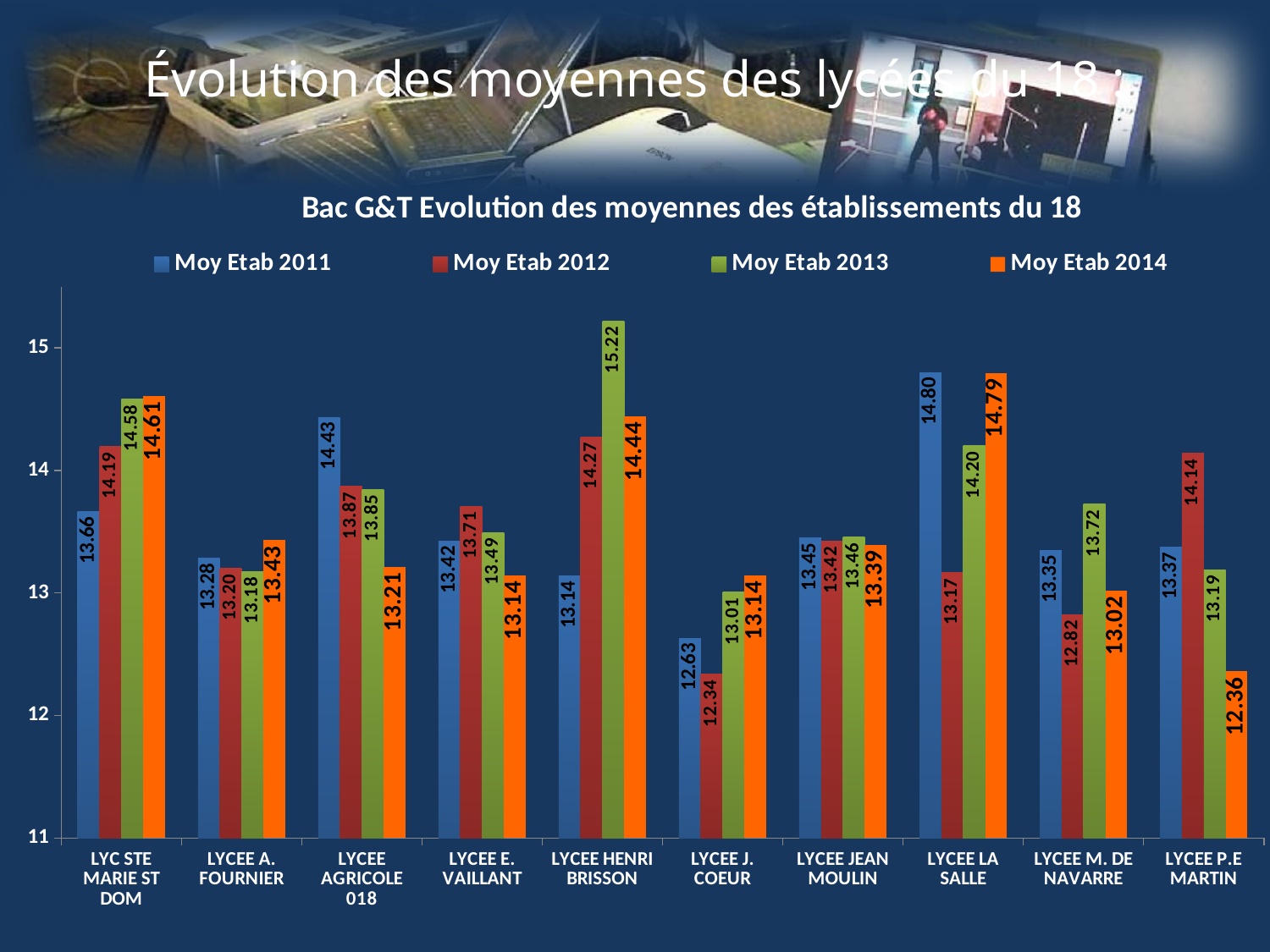
What kind of chart is shown? bar chart What is the Moy Etab 2013 value for LYCEE M. DE NAVARRE? 13.72 Is the Moy Etab 2012 value for LYCEE J. COEUR greater or less than 13? less Which lycée has the highest Moy Etab 2013 value? LYCEE HENRI BRISSON Which is larger: the Moy Etab 2011 value for LYCEE AGRICOLE 018 or for LYCEE LA SALLE? LYCEE LA SALLE What is the Moy Etab 2011 value for LYCEE HENRI BRISSON? 13.14 How many lycées are shown on the x axis? 10 How many series does the legend list? 4 Which lycée has the lowest Moy Etab 2014 value? LYCEE P.E MARTIN Do the values for LYCEE AGRICOLE 018 rise or fall from Moy Etab 2011 to Moy Etab 2014? fall What is the difference between the Moy Etab 2013 and Moy Etab 2011 values for LYCEE HENRI BRISSON? 2.08 Which lycée has the highest Moy Etab 2014 value? LYCEE LA SALLE